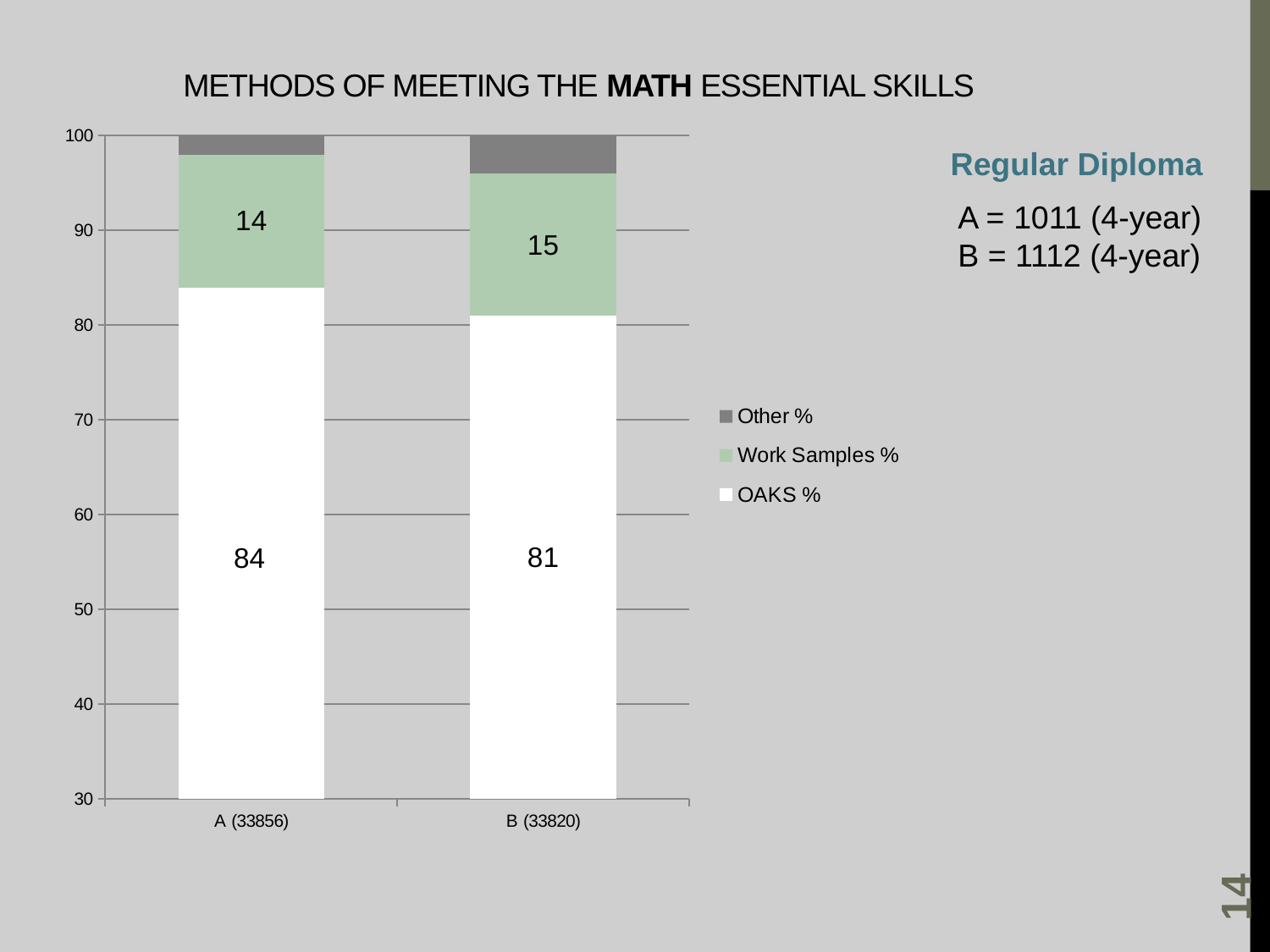
What kind of chart is shown on the slide? Stacked bar chart What is the title of the chart on the slide? METHODS OF MEETING THE MATH ESSENTIAL SKILLS What is the Work Samples % value for category A (33856)? 14 What is the difference between the Work Samples % values for B (33820) and A (33856)? 1 Which category has the higher OAKS % value, A (33856) or B (33820)? A (33856) Which category has the higher Work Samples % value, A (33856) or B (33820)? B (33820) How many series does the chart legend list? 3 How many categories are shown on the x axis of the chart? 2 What is the OAKS % value for category B (33820)? 81 What is the OAKS % value for category A (33856)? 84 What is the Work Samples % value for category B (33820)? 15 What is the difference between the OAKS % values for A (33856) and B (33820)? 3